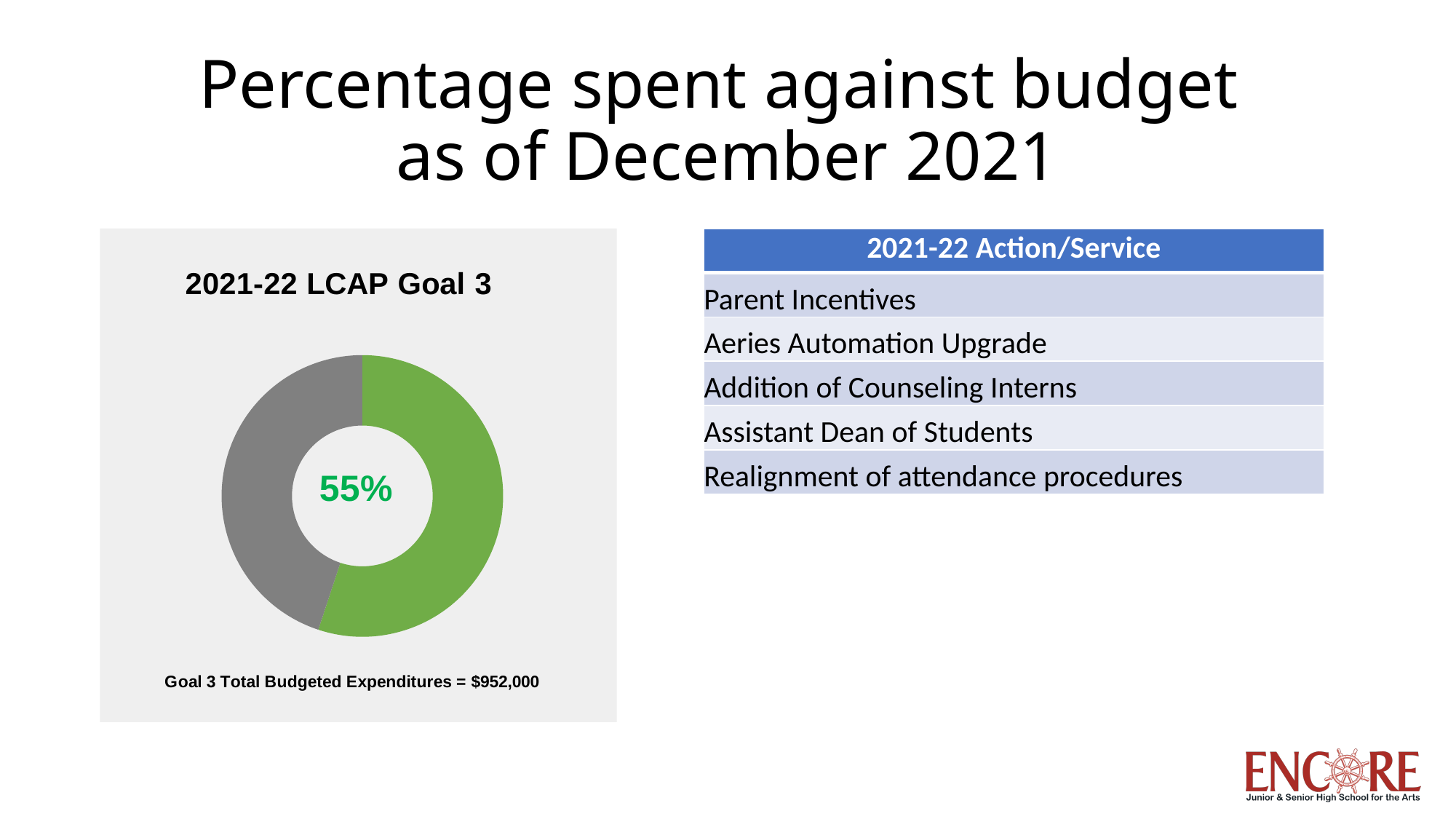
What share of the doughnut does the green slice represent? 55% By how many percentage points does the green slice exceed the grey slice? 10 percentage points Is the green slice's share greater or less than 50%? greater How many slices does the doughnut chart have? 2 According to the text below the chart, what are the Goal 3 Total Budgeted Expenditures? $952,000 What is the title of the chart? 2021-22 LCAP Goal 3 What percentage is printed in the centre of the doughnut chart? 55% What kind of chart is shown on the slide? doughnut chart What share of the doughnut does the grey slice represent? 45% Which slice is larger, the green one or the grey one? green What colour is the larger slice of the doughnut chart? green